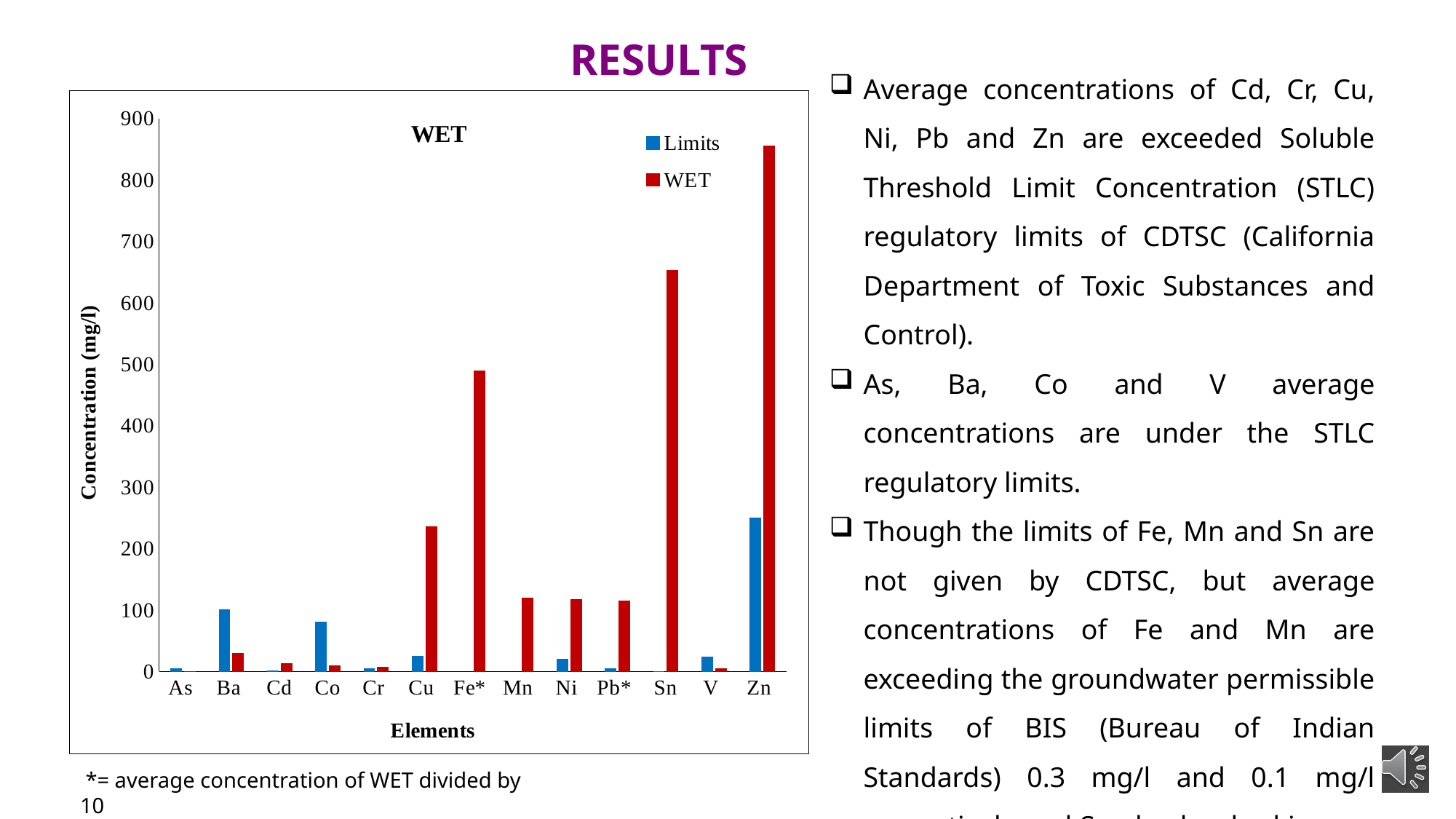
What is the label of the y axis? Concentration (mg/l) How many series does the legend list? 2 Which element has the highest WET concentration? Zn Which is larger for Zn, the Limits value or the WET value? WET What kind of chart is shown on the slide? bar chart Is the Limits value for Co greater or less than 100? less How many elements are shown on the x axis? 13 Is the WET value for Zn greater or less than 800? greater Is the WET value for Fe* greater or less than 400? greater Which element has the highest Limits value? Zn Which is larger, the WET value for Sn or the WET value for Fe*? Sn